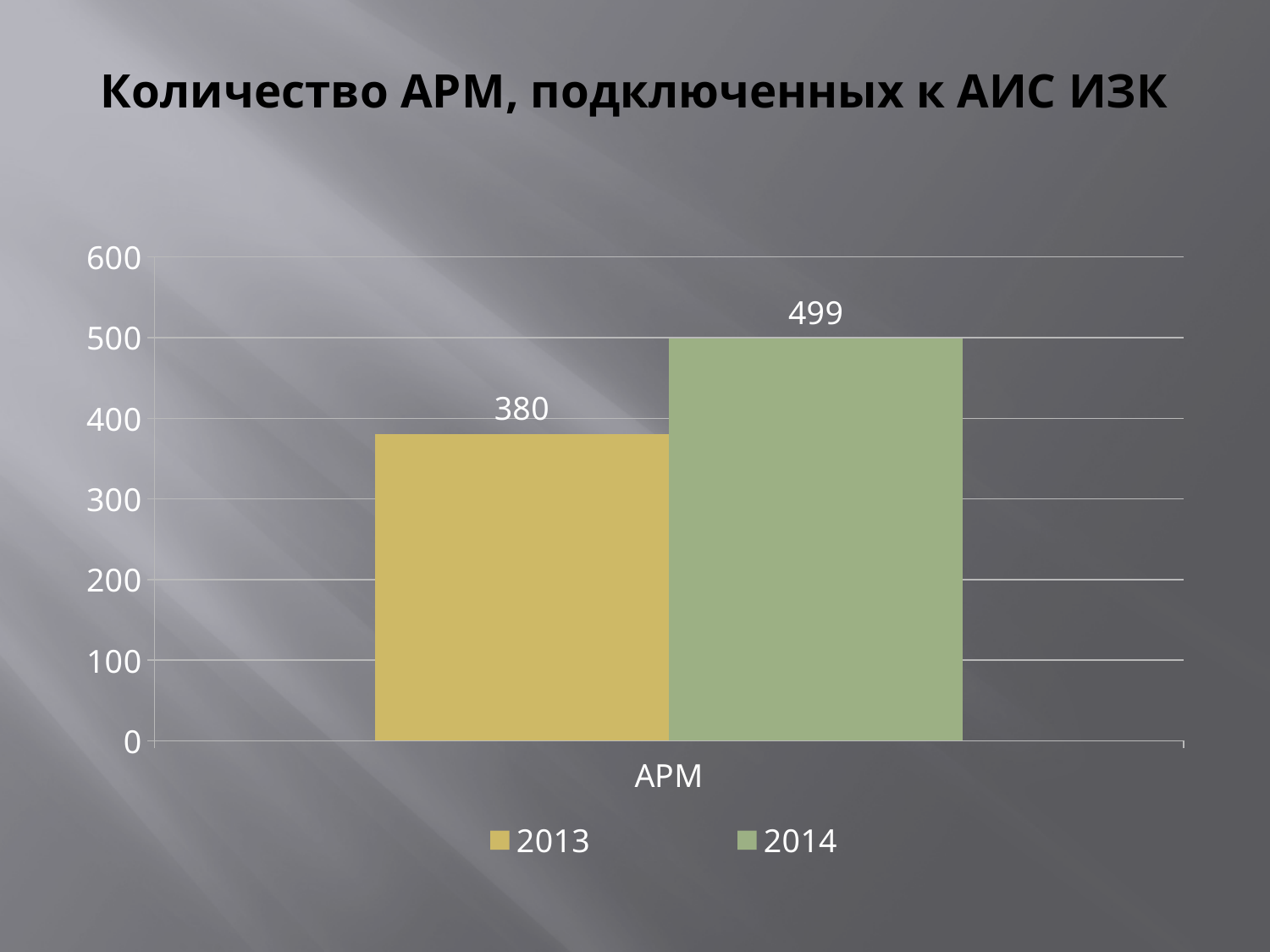
Is the value for 2014 greater or less than 400? greater Which series has the lowest value in the chart? 2013 What kind of chart is shown on the slide? bar chart What is the value for 2014 in the chart? 499 Which series has the highest value in the chart? 2014 What is the difference between the 2014 value and the 2013 value? 119 Is the value for 2013 greater or less than 400? less Which year has the higher value, 2013 or 2014? 2014 How many series does the legend list? 2 What is the value for 2013 in the chart? 380 What is the title of the chart? Количество АРМ, подключенных к АИС ИЗК What is the category label on the x axis? АРМ